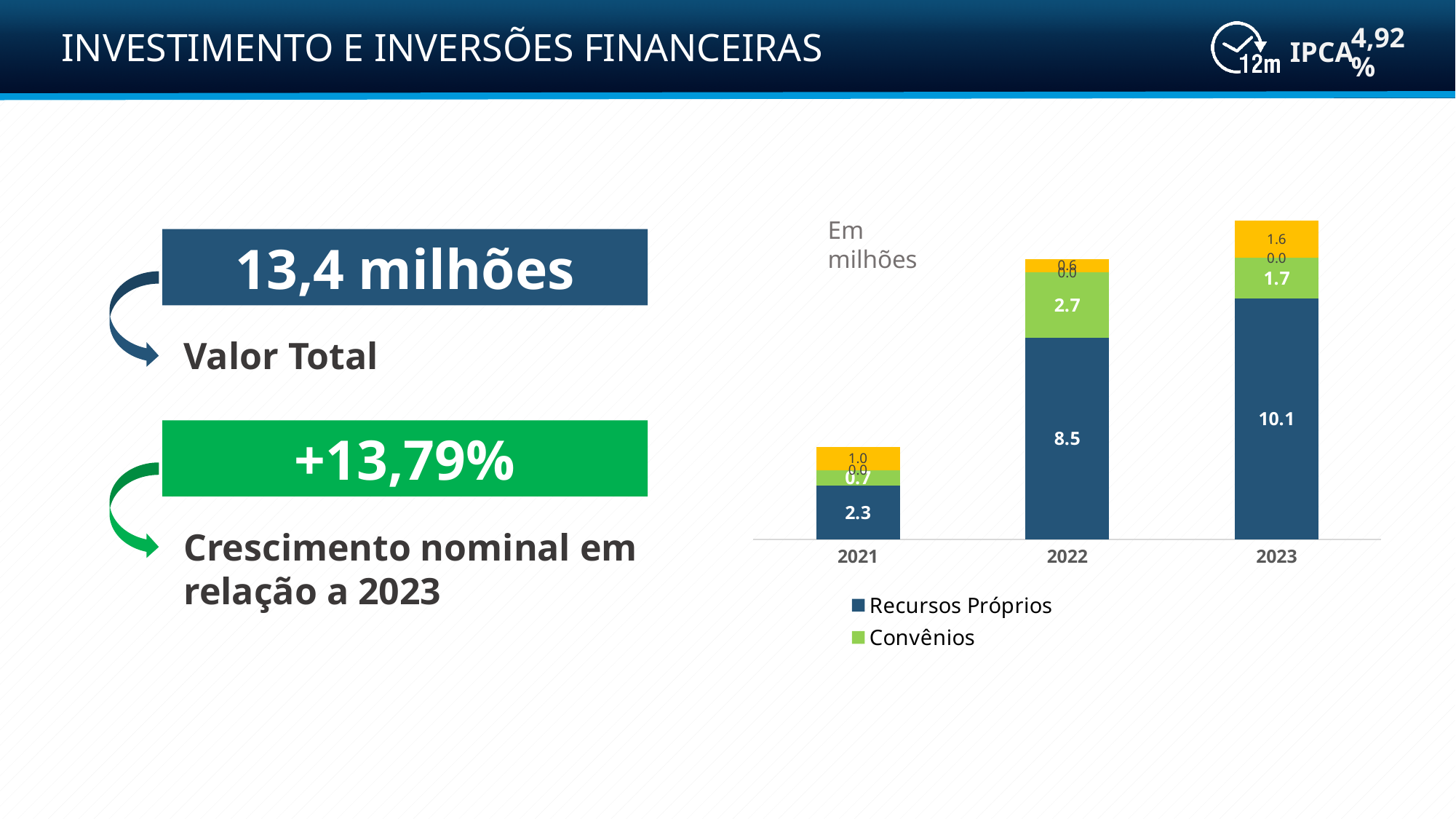
What is the value for Recursos Próprios in 2023? 10.1 What is the difference between Recursos Próprios in 2023 and in 2022? 1.6 Does Recursos Próprios rise or fall from 2021 to 2023? Rise What is the difference between Convênios in 2022 and in 2021? 2.0 In which year is Convênios lowest? 2021 How many series does the chart legend list? 2 How many years are shown on the x axis of the chart? 3 What is the value for Convênios in 2022? 2.7 In 2022, which is larger: Recursos Próprios or Convênios? Recursos Próprios In which year is Recursos Próprios highest? 2023 What kind of chart is shown on the slide? Stacked bar chart What is the value for Recursos Próprios in 2021? 2.3